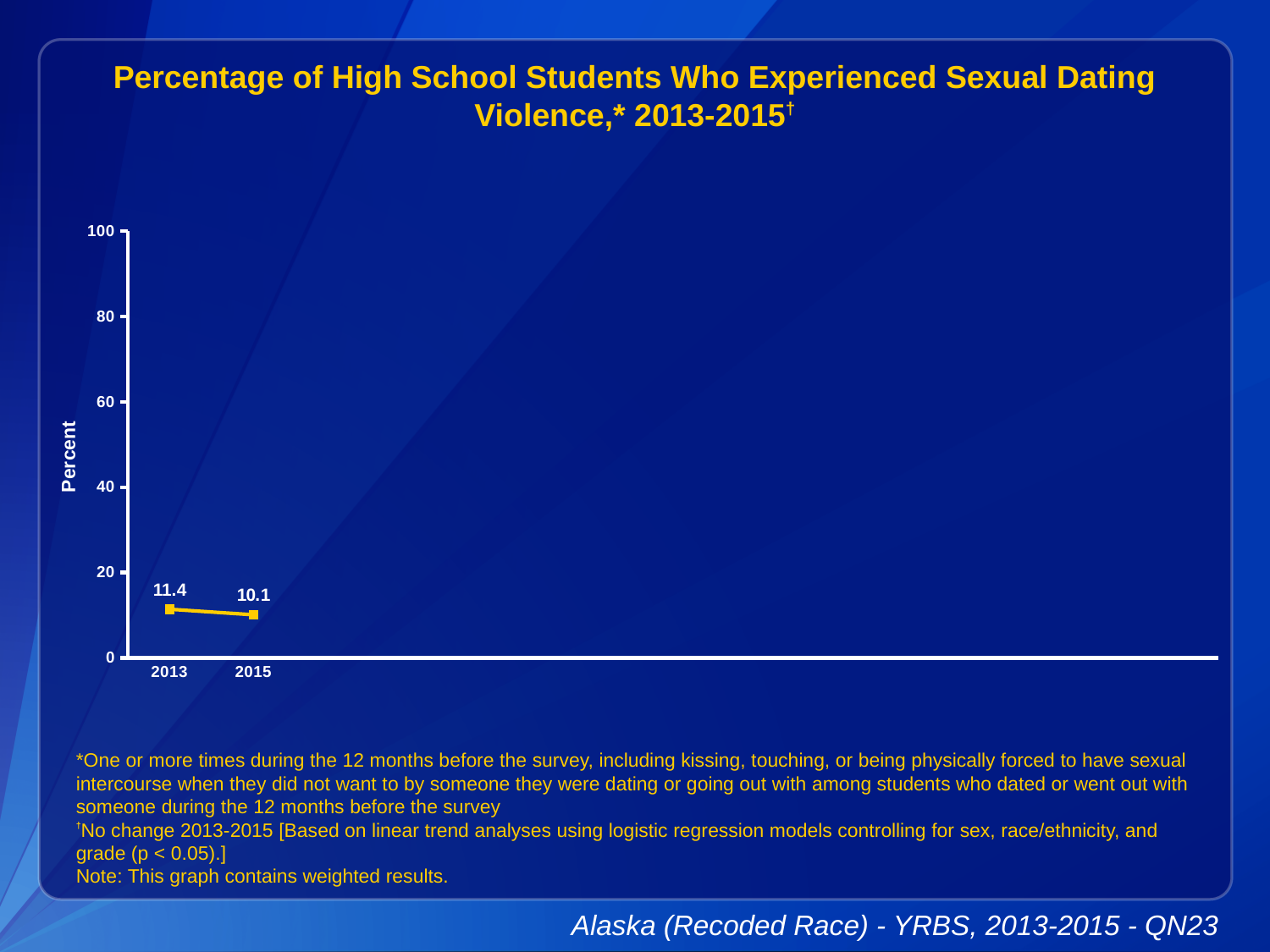
What is the maximum value shown on the vertical axis? 100 What is the value for 2015? 10.1 Which is larger, the value for 2013 or the value for 2015? 2013 How many data points are plotted on the chart? 2 Is the value for 2013 greater or less than 20? less What is the value for 2013? 11.4 What is the difference between the values for 2013 and 2015? 1.3 Do the values rise or fall from 2013 to 2015? fall What kind of chart is shown on the slide? line chart Which year has the lowest value? 2015 Which year has the highest value? 2013 What is the label on the vertical axis? Percent